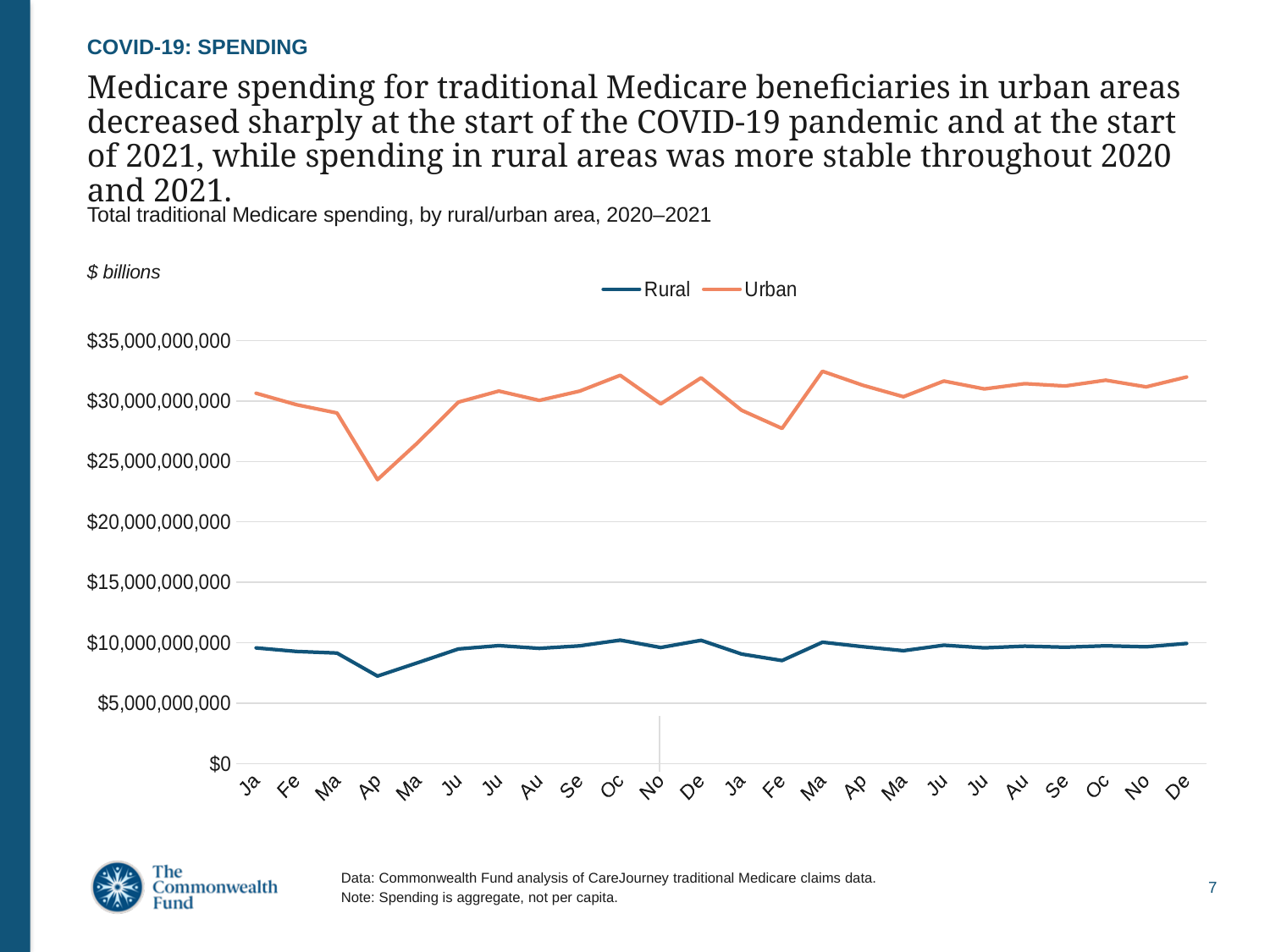
At which month does the Rural line reach its lowest point? April 2020 (first 'Ap') How many monthly data points does each line have? 24 Is the Urban value at the first 'Ap' label (April 2020) greater or less than $25,000,000,000? less What type of chart is shown on the slide? line chart At which month does the Urban line reach its lowest point? April 2020 (first 'Ap') What are the two series named in the legend? Rural and Urban What is the unit label shown above the y-axis? $ billions How many series does the legend list? 2 Which series has the higher spending throughout the chart, Rural or Urban? Urban Is the Rural value at the first 'Ap' label (April 2020) greater or less than $10,000,000,000? less Is the Urban value at the second 'Fe' label (February 2021) greater or less than $30,000,000,000? less Does the Urban line rise or fall between the first 'Ap' label (April 2020) and the first 'Ju' label (June 2020)? rise